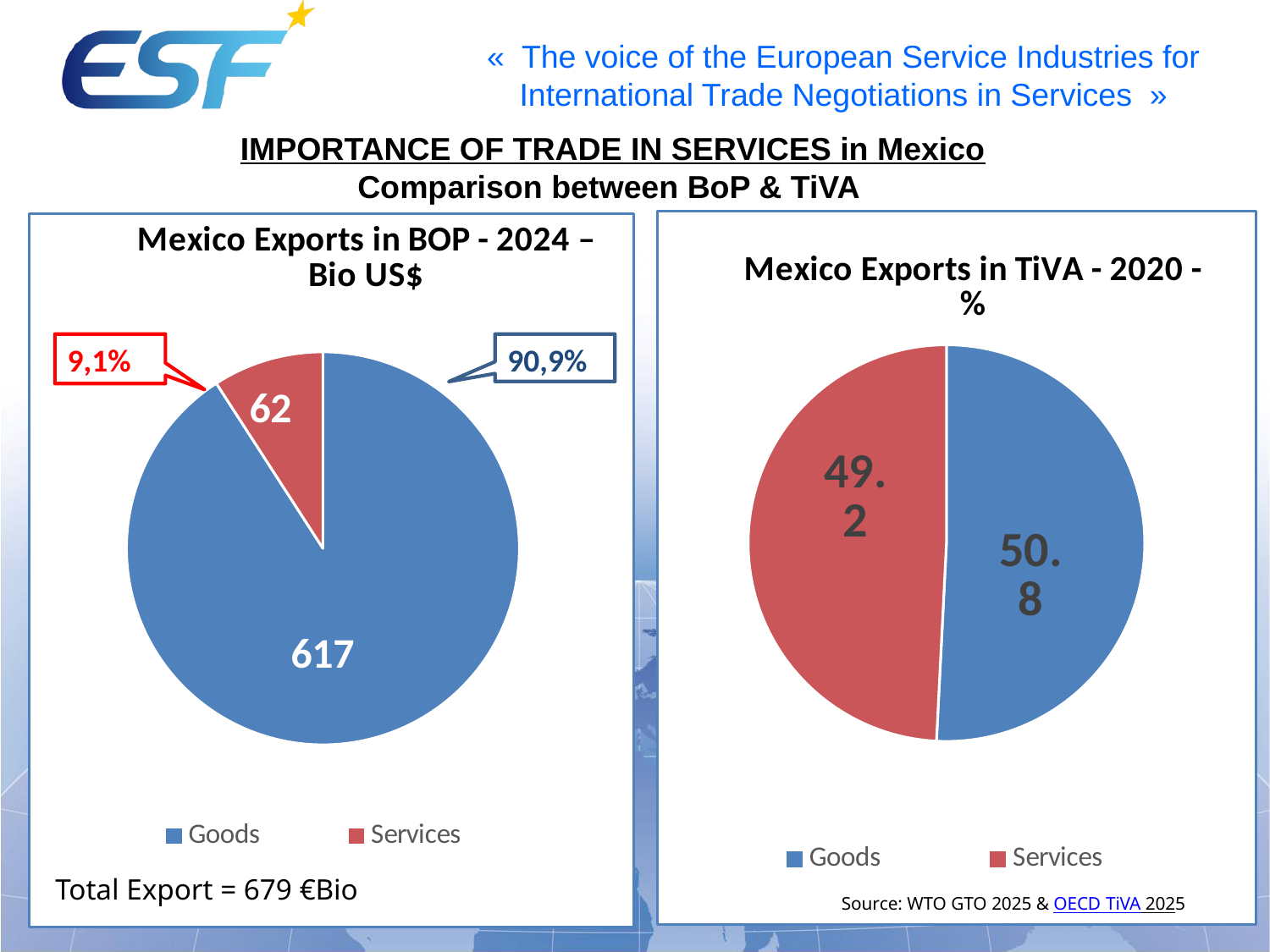
In the 'Mexico Exports in BOP - 2024' chart, what is the difference between the Goods and Services values? 555 In the 'Mexico Exports in TiVA - 2020' chart, what is the value for Services? 49.2 In the 'Mexico Exports in BOP - 2024' chart, which category has the largest slice? Goods In the 'Mexico Exports in TiVA - 2020' chart, what is the difference between the Goods and Services values? 1.6 In the 'Mexico Exports in BOP - 2024' chart, what is the value for Services? 62 In the 'Mexico Exports in BOP - 2024' chart, what share of the pie does Services represent, according to the callout label? 9,1% In the 'Mexico Exports in TiVA - 2020' chart, which category has the smallest slice? Services In the 'Mexico Exports in BOP - 2024' chart, what share of the pie does Goods represent, according to the callout label? 90,9% What kind of chart is the 'Mexico Exports in TiVA - 2020' chart? Pie chart In the 'Mexico Exports in BOP - 2024' chart, what is the value for Goods? 617 In the 'Mexico Exports in TiVA - 2020' chart, what is the value for Goods? 50.8 How many entries does the legend of the 'Mexico Exports in BOP - 2024' chart list? 2